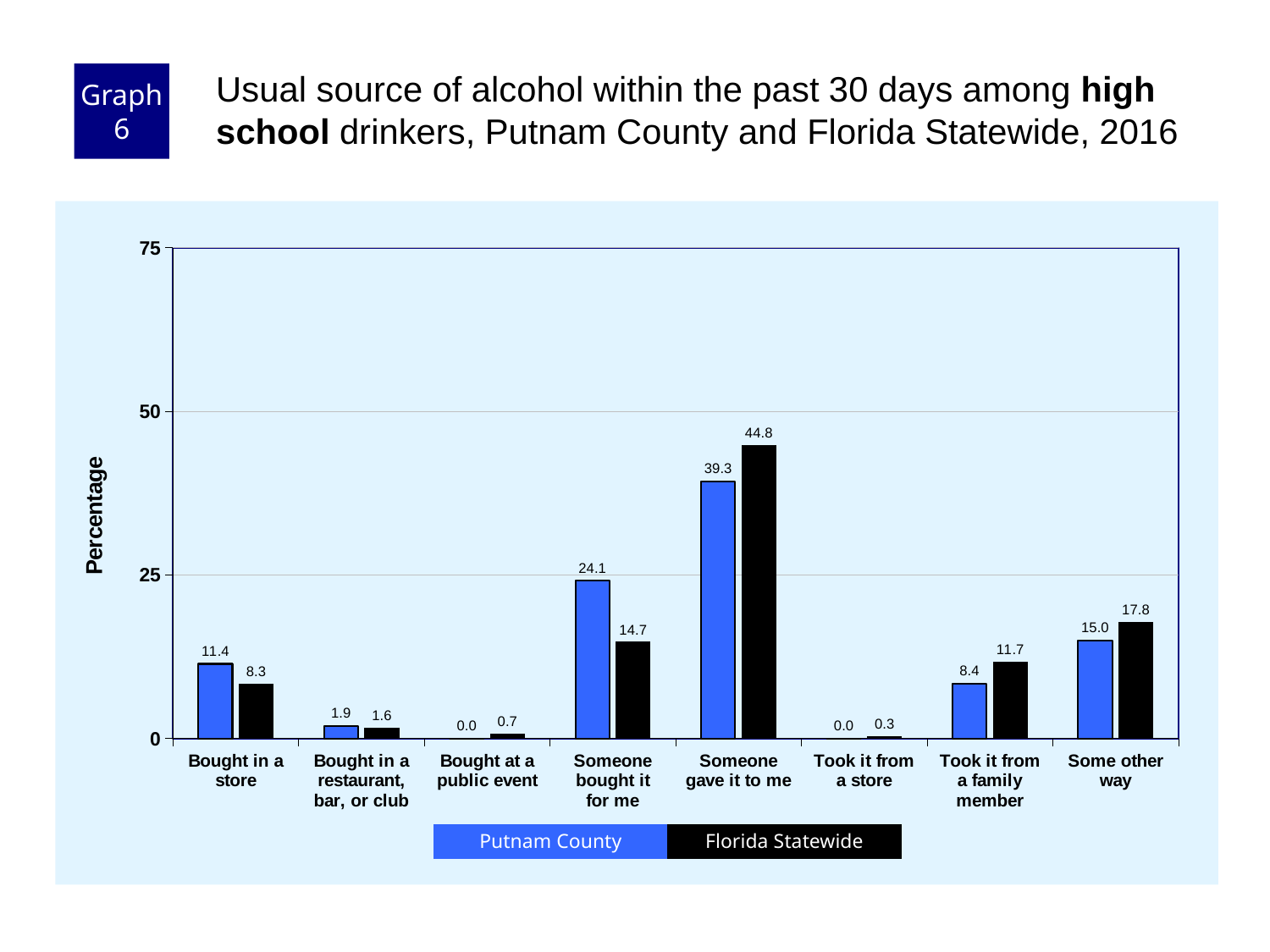
Which category has the highest Florida Statewide value? Someone gave it to me What is the Putnam County value for "Bought in a store"? 11.4 Is the Florida Statewide value for "Someone gave it to me" greater or less than 50? less Which category has the lowest Florida Statewide value? Took it from a store What is the Putnam County value for "Someone gave it to me"? 39.3 What is the Florida Statewide value for "Someone bought it for me"? 14.7 How many categories are shown on the x axis? 8 What is the difference between the Florida Statewide and Putnam County values for "Someone gave it to me"? 5.5 How many series does the legend list? 2 What is the label of the y axis? Percentage Which is larger for "Someone bought it for me": Putnam County or Florida Statewide? Putnam County What kind of chart is shown on the slide? Bar chart